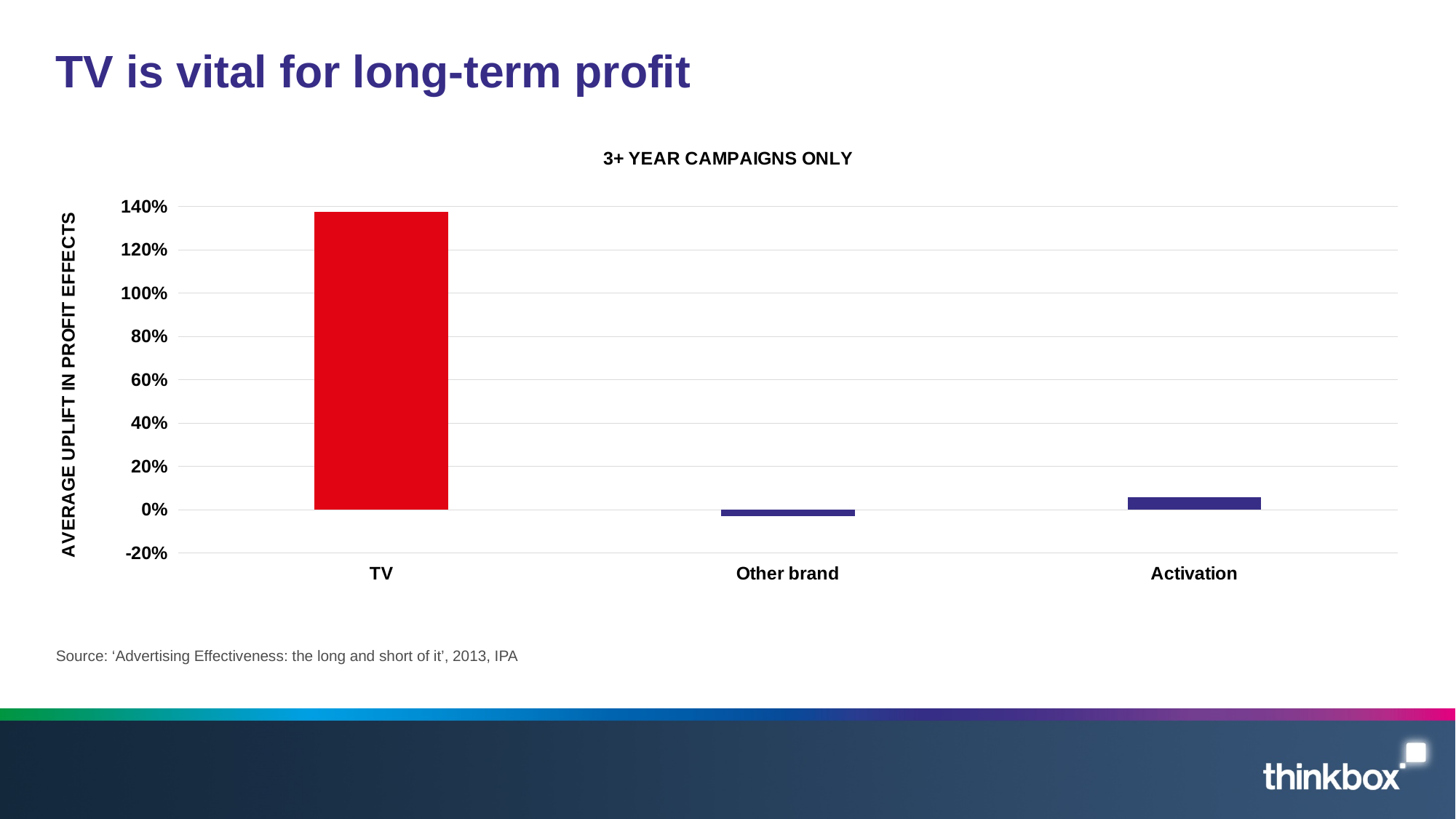
Which category has the highest average uplift in profit effects? TV Which has a larger average uplift in profit effects, Activation or Other brand? Activation Which category has the lowest average uplift in profit effects? Other brand What type of chart is shown on the slide? Bar chart Which has a larger average uplift in profit effects, TV or Activation? TV Is the value for Activation greater or less than 20%? less Is the value for Other brand greater or less than 0%? less What is the label on the vertical axis of the chart? AVERAGE UPLIFT IN PROFIT EFFECTS Is the value for TV greater or less than 120%? greater How many categories are shown on the x axis of the chart? 3 What is the title shown above the chart? 3+ YEAR CAMPAIGNS ONLY